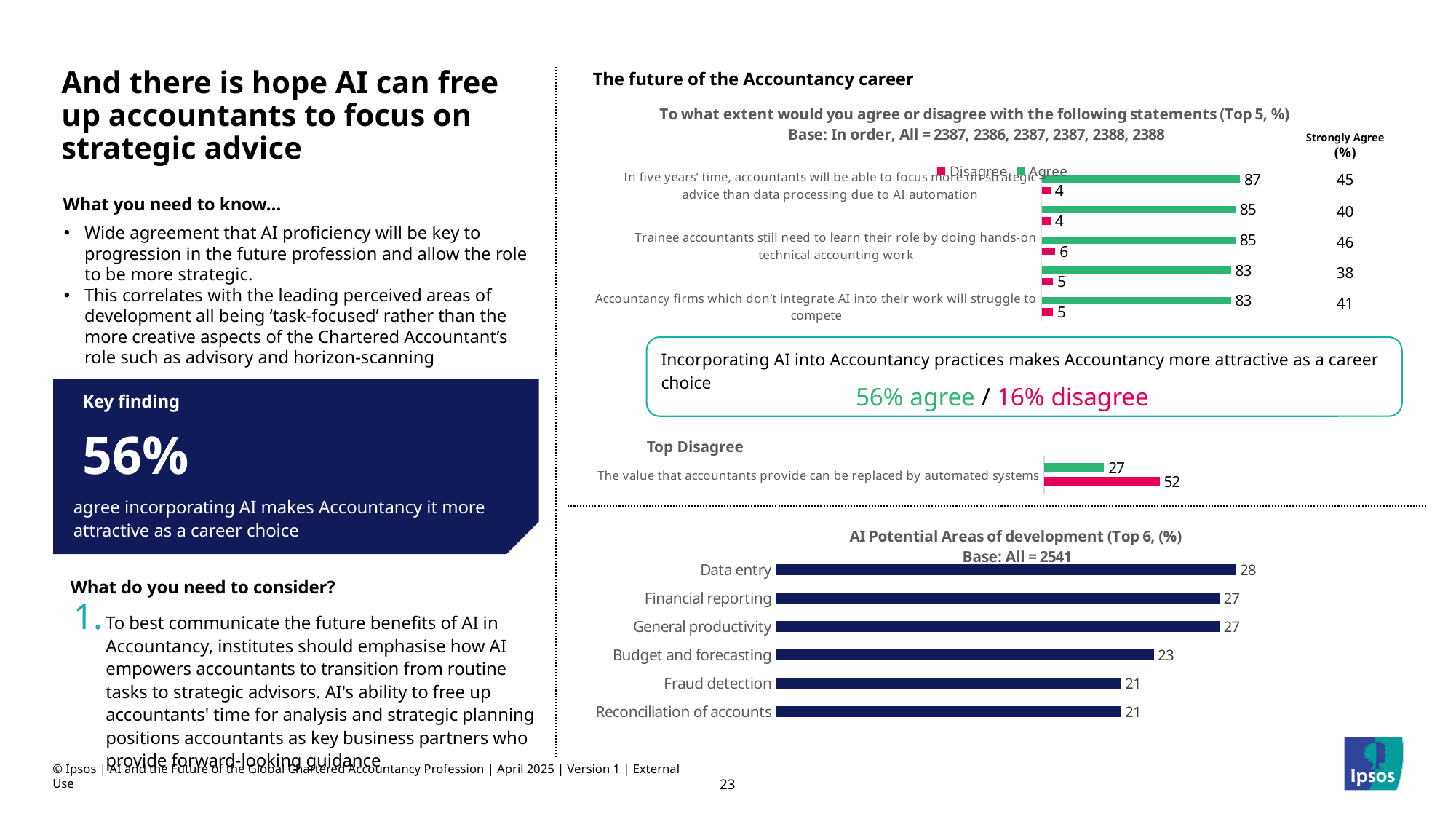
In the 'To what extent would you agree or disagree' chart, what is the Disagree value for the statement that trainee accountants still need to learn their role by doing hands-on technical accounting work? 6 In the 'AI Potential Areas of development' chart, how many areas of development are listed? 6 In the 'Top Disagree' chart, what is the Disagree value for the statement that the value accountants provide can be replaced by automated systems? 52 In the 'To what extent would you agree or disagree' chart, what is the Agree value for the statement that in five years' time accountants will be able to focus more on strategic advice than data processing due to AI automation? 87 What kind of chart is the 'AI Potential Areas of development' chart? Bar chart In the 'AI Potential Areas of development' chart, what is the difference between Data entry and Fraud detection? 7 In the 'AI Potential Areas of development' chart, which area has the highest value? Data entry How many series does the legend of the 'To what extent would you agree or disagree' chart list? 2 In the 'Top Disagree' chart, which is larger for the statement shown: Agree or Disagree? Disagree In the 'To what extent would you agree or disagree' chart, what is the Strongly Agree (%) value for the statement that accountancy firms which don't integrate AI into their work will struggle to compete? 41 In the 'AI Potential Areas of development' chart, what is the value for Budget and forecasting? 23 In the 'AI Potential Areas of development' chart, what is the value for Data entry? 28